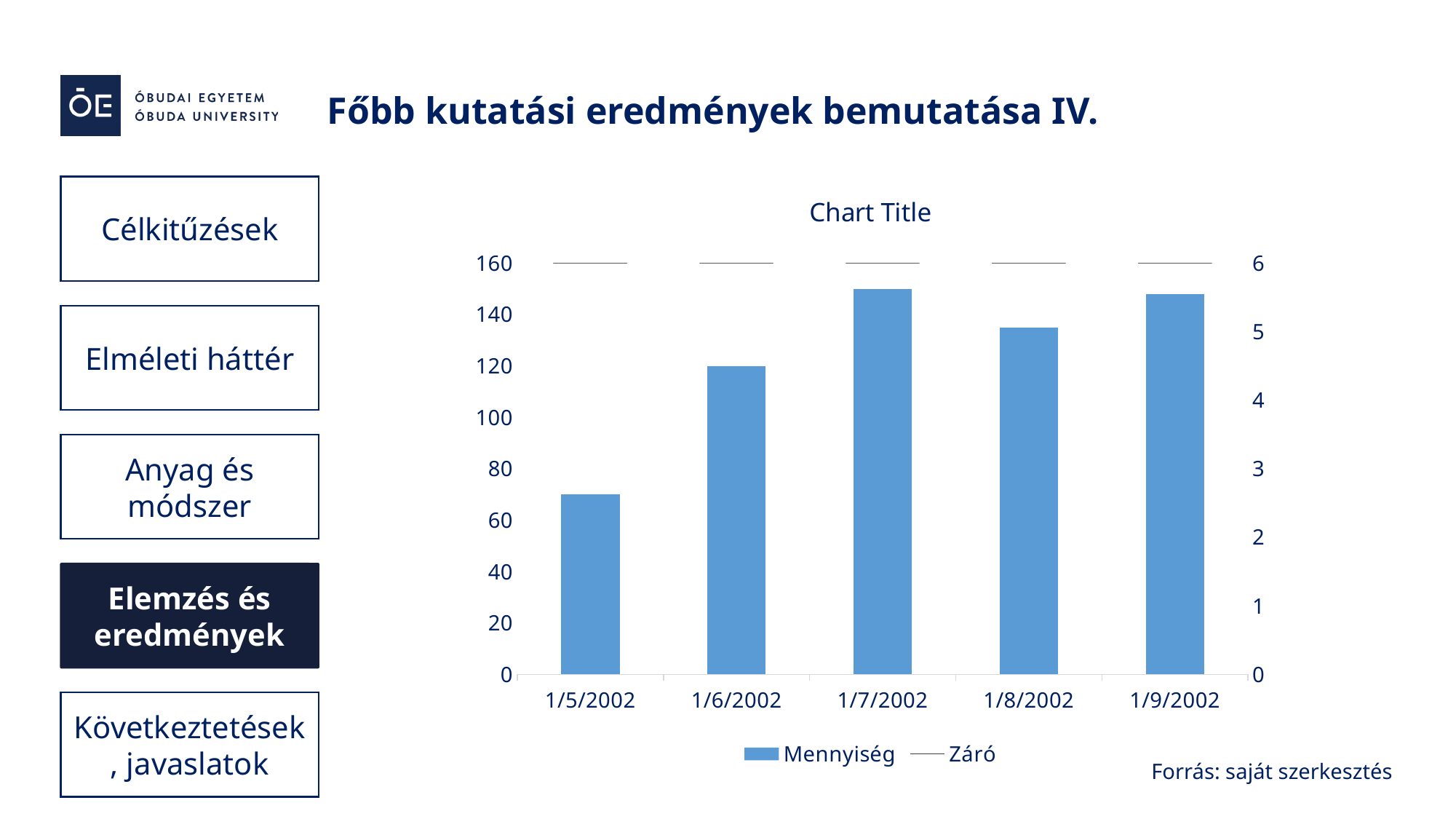
Is the Mennyiség value for 1/8/2002 greater or less than 120? greater Is the Mennyiség value for 1/5/2002 greater or less than 80? less What kind of chart is shown on the slide? bar chart How many series does the chart legend list? 2 Which has the larger Mennyiség value, 1/6/2002 or 1/8/2002? 1/8/2002 What are the two series named in the chart legend? Mennyiség and Záró Which date has the lowest Mennyiség value? 1/5/2002 Is the Mennyiség value for 1/7/2002 greater or less than 140? greater What is the Mennyiség value for 1/6/2002? 120 What is the title of the chart? Chart Title How many dates are shown on the x axis of the chart? 5 Do the Mennyiség values rise or fall from 1/5/2002 to 1/7/2002? rise